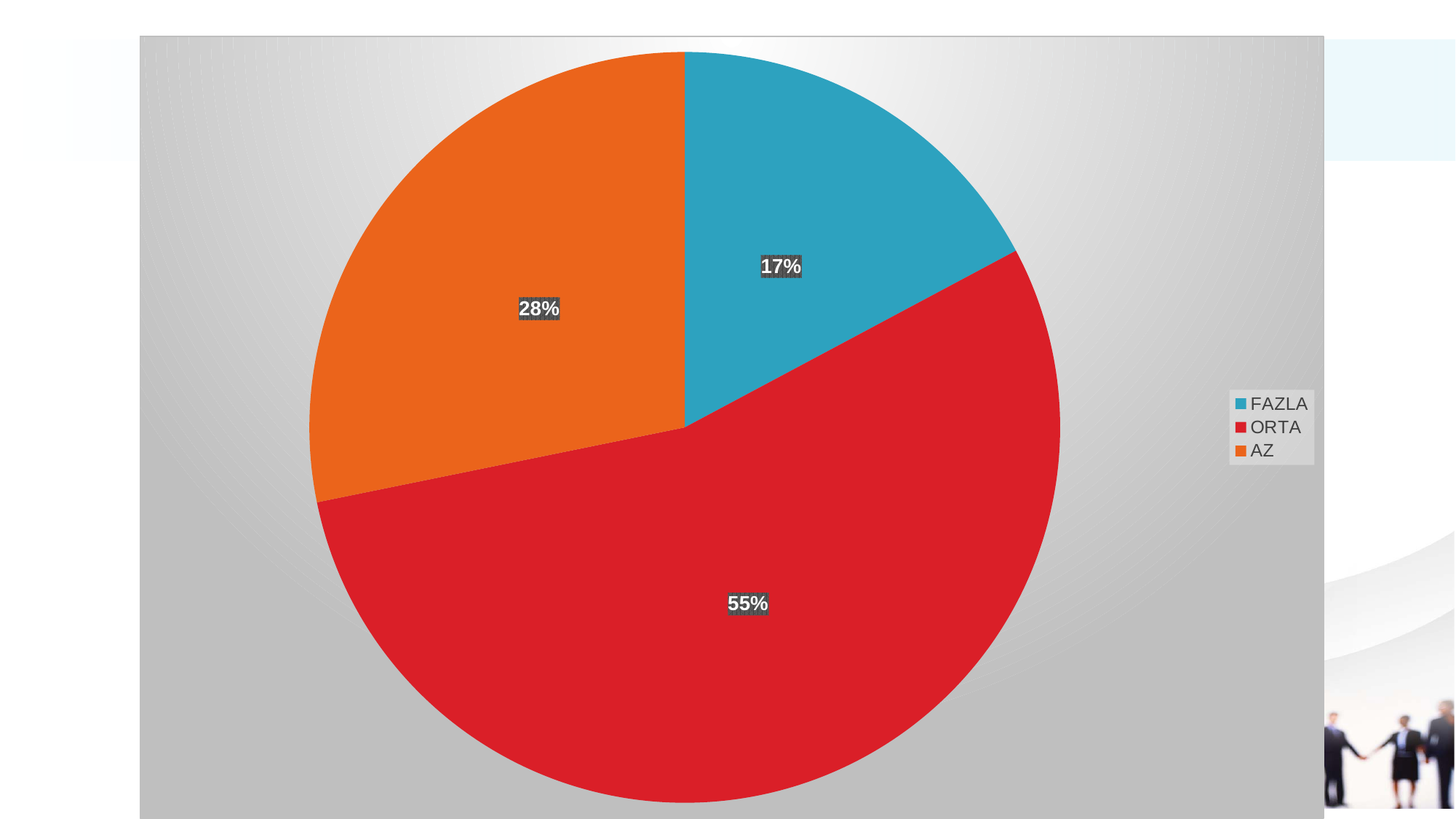
Which is larger, the AZ slice or the FAZLA slice? AZ What percentage does the FAZLA slice show? 17% What colour is the ORTA slice? red What colour is the AZ slice? orange What percentage does the AZ slice show? 28% How many slices does the pie chart have? 3 What percentage does the ORTA slice show? 55% What is the difference in percentage points between the ORTA and AZ slices? 27 What kind of chart is shown on the slide? pie chart Which category has the largest share of the pie? ORTA How many entries does the legend list? 3 Which category has the smallest share of the pie? FAZLA